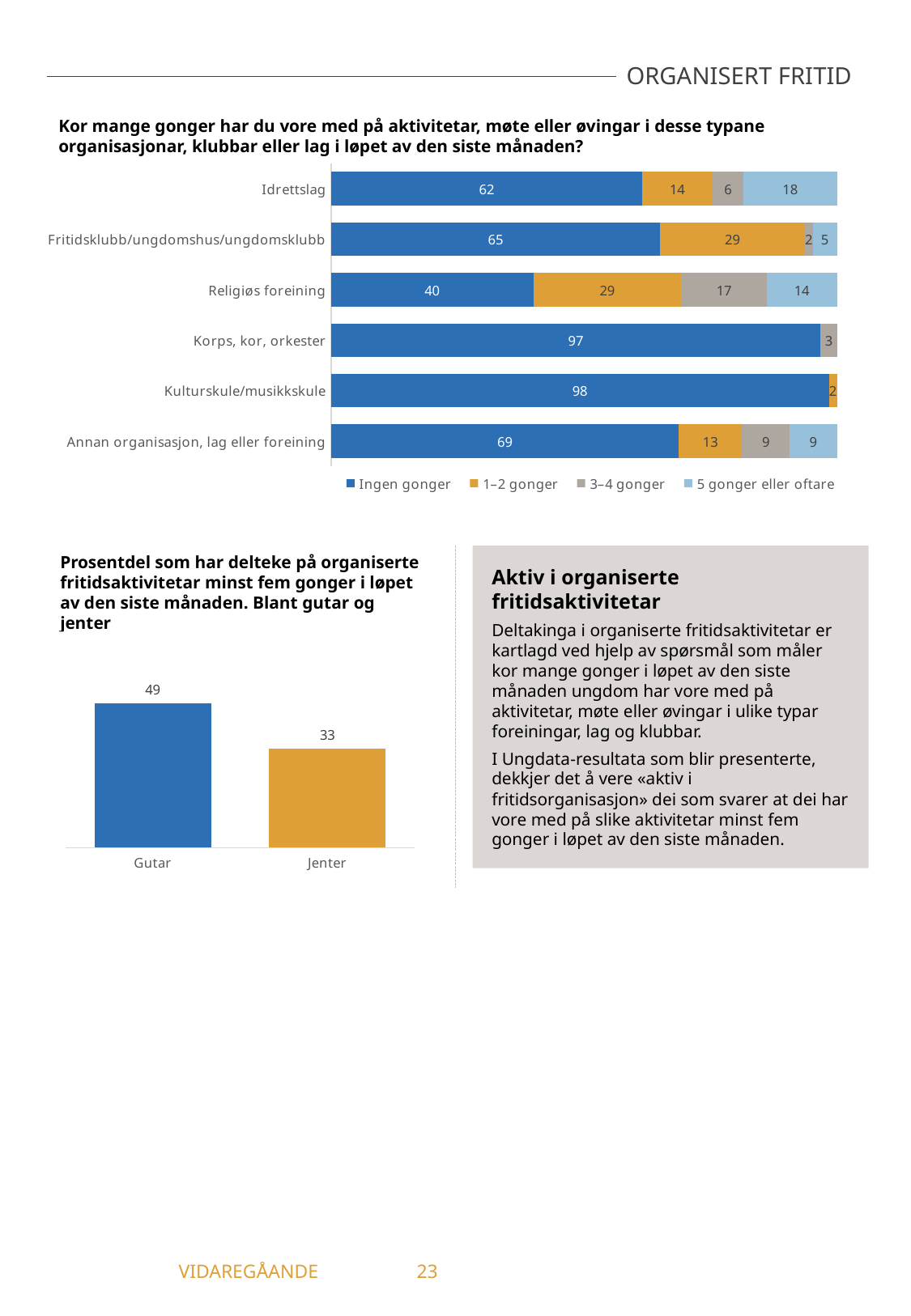
In the top chart, which category has the lowest "Ingen gonger" value? Religiøs foreining How many series does the legend of the top chart list? 4 In the top chart, what is the value for "5 gonger eller oftare" for Religiøs foreining? 14 In the top chart, which category has the highest "Ingen gonger" value? Kulturskule/musikkskule In the bottom-left chart, what is the value for Jenter? 33 How many categories are shown in the top chart? 6 In the top chart, which is larger: the "5 gonger eller oftare" value for Idrettslag or for Annan organisasjon, lag eller foreining? Idrettslag In the top chart, what is the difference between the "Ingen gonger" values for Annan organisasjon, lag eller foreining and Idrettslag? 7 In the bottom-left chart, what is the difference between the values for Gutar and Jenter? 16 In the top chart, what is the value for "1–2 gonger" for Fritidsklubb/ungdomshus/ungdomsklubb? 29 In the top chart, what percentage answered "Ingen gonger" for Idrettslag? 62 What kind of chart is the bottom-left chart (Gutar and Jenter)? Bar chart